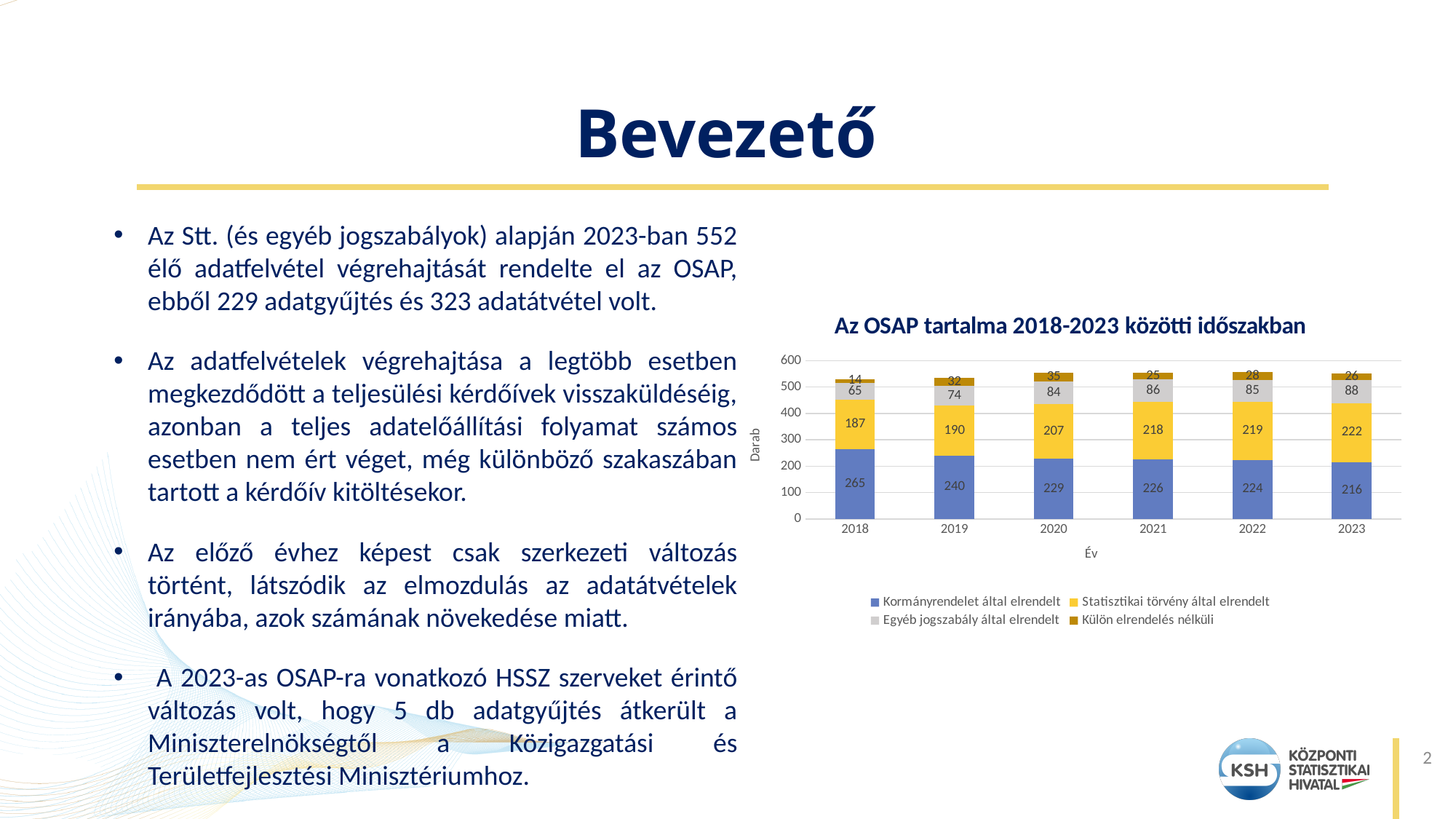
In which year is the 'Külön elrendelés nélküli' value the lowest? 2018 Does the 'Kormányrendelet által elrendelt' value rise or fall from 2018 to 2023? Fall What kind of chart is shown on the slide? Stacked bar chart In which year is the 'Kormányrendelet által elrendelt' value the highest? 2018 What is the value for 'Statisztikai törvény által elrendelt' in 2023? 222 What is the title of the chart? Az OSAP tartalma 2018-2023 közötti időszakban What is the difference between the 'Kormányrendelet által elrendelt' values in 2018 and 2023? 49 What is the value for 'Egyéb jogszabály által elrendelt' in 2020? 84 What is the total of the stacked bar for 2023? 552 What is the value for 'Kormányrendelet által elrendelt' in 2018? 265 How many years are shown on the x axis of the chart? 6 How many series does the chart legend list? 4